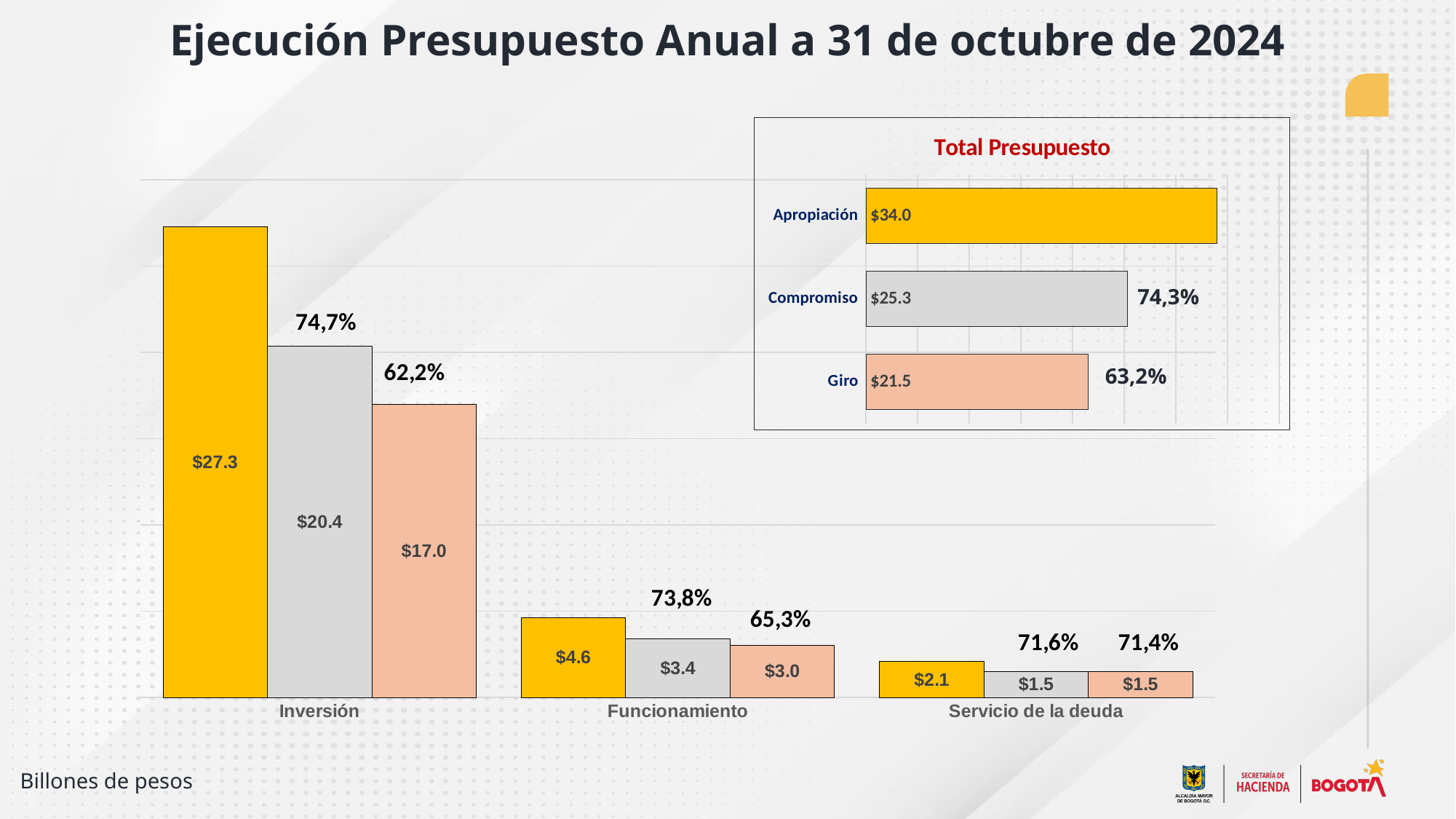
In the main bar chart, what is the Apropiación (yellow bar) value for Inversión? $27.3 In the main bar chart, what is the difference between the Apropiación ($27.3) and Compromiso ($20.4) values for Inversión? $6.9 In the Total Presupuesto chart, what is the difference between the Apropiación ($34.0) and Giro ($21.5) values? $12.5 In the Total Presupuesto chart, what percentage is shown next to the Giro bar? 63,2% How many categories are shown on the x axis of the main bar chart? 3 In the main bar chart, what is the Giro (peach bar) value for Funcionamiento? $3.0 In the main bar chart, which category has the highest Apropiación (yellow bar) value? Inversión In the Total Presupuesto chart, what is the value for Compromiso? $25.3 In the main bar chart, what percentage is shown above the Compromiso (gray) bar for Servicio de la deuda? 71,6% In the main bar chart, which is larger: the Compromiso value for Funcionamiento or the Apropiación value for Servicio de la deuda? Compromiso value for Funcionamiento ($3.4) In the main bar chart, which category has the lowest Giro (peach bar) value? Servicio de la deuda What kind of chart is the main chart on the slide? Bar chart